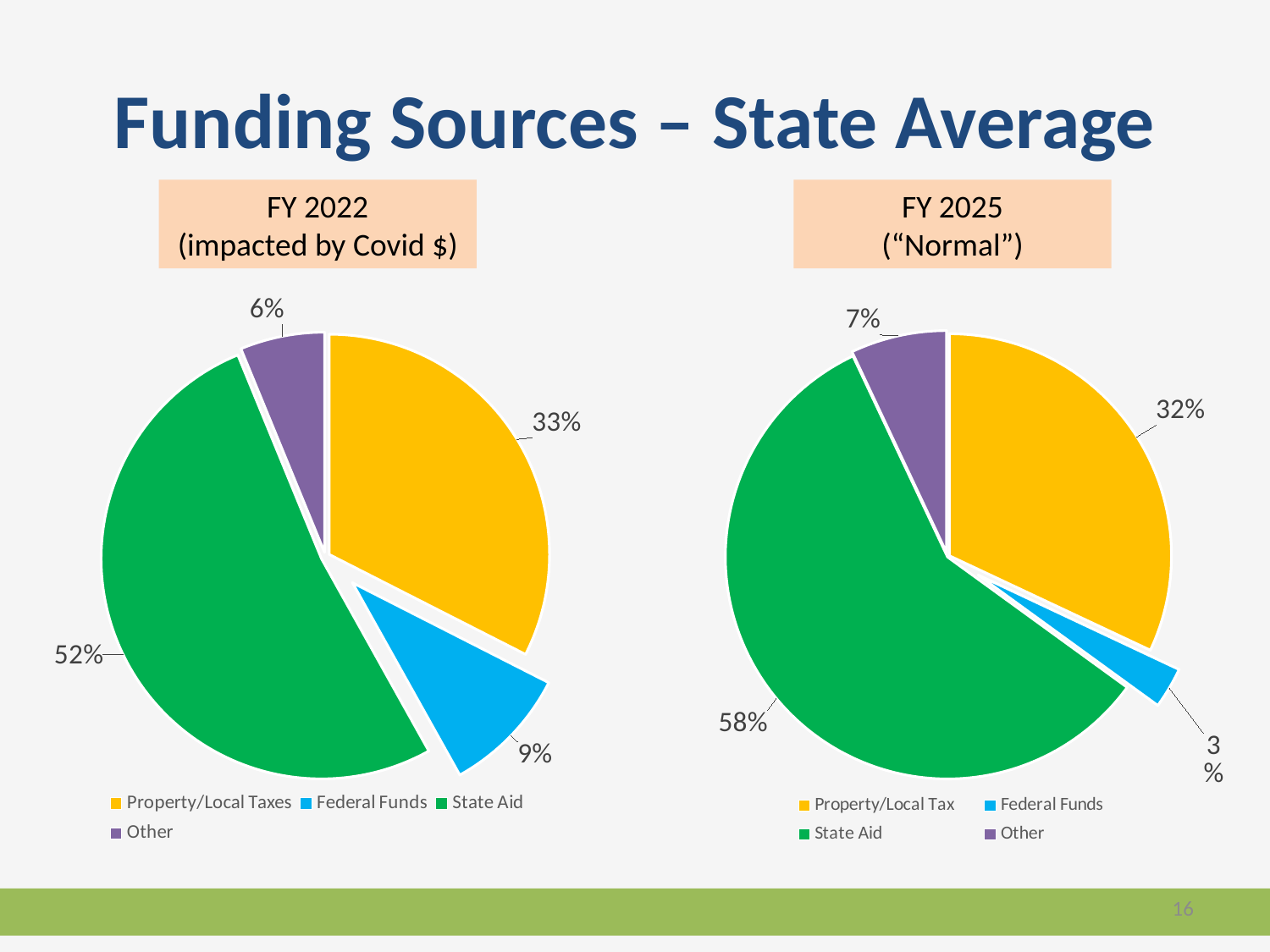
In the FY 2022 pie chart, what share does State Aid have? 52% In the FY 2025 pie chart, what share does State Aid have? 58% In the FY 2025 pie chart, what share does Property/Local Tax have? 32% In the FY 2022 pie chart, which category has the smallest slice? Other In the FY 2025 pie chart, which category has the smallest slice? Federal Funds What type of chart is used on this slide? Pie chart What is the difference between the Federal Funds share in FY 2022 and in FY 2025? 6% How many slices does the FY 2022 pie chart have? 4 In the FY 2022 pie chart, what share does Federal Funds have? 9% In the FY 2025 pie chart, which colour represents State Aid? Green In the FY 2022 pie chart, which category has the largest slice? State Aid